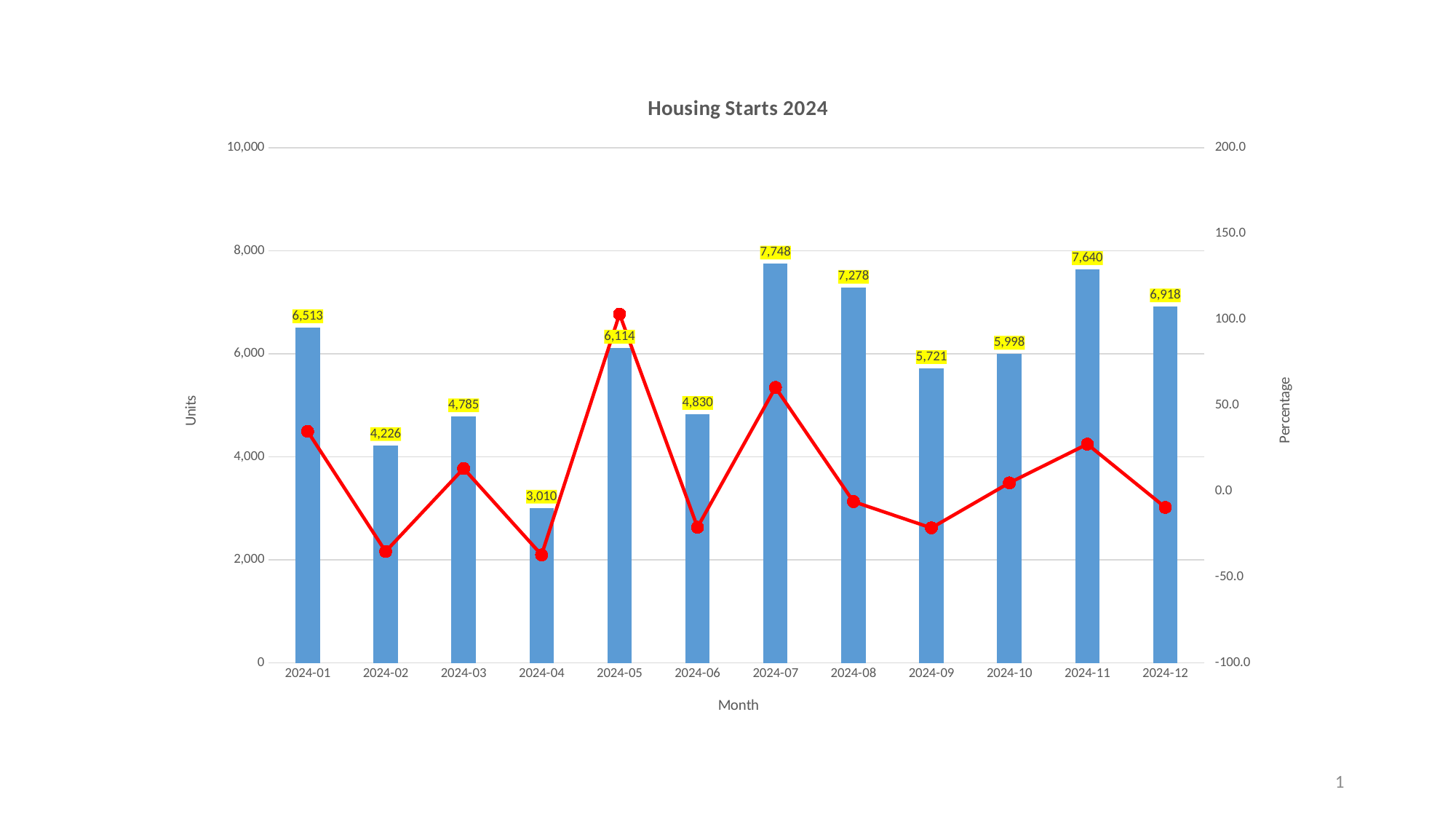
Do the bar values rise or fall from 2024-07 to 2024-09? fall What is the difference between the bar values for 2024-01 and 2024-02? 2,287 What is the value for 2024-07 in the Housing Starts 2024 chart? 7,748 What is the difference between the bar values for 2024-07 and 2024-04? 4,738 Which month has the lowest bar in the Housing Starts 2024 chart? 2024-04 How many months are shown on the x axis of the Housing Starts 2024 chart? 12 Is the percentage value (red line) for 2024-02 greater or less than 0.0? less Is the percentage value (red line) for 2024-07 greater or less than 50.0? greater Which month has a larger bar value, 2024-08 or 2024-11? 2024-11 Which month has the highest bar in the Housing Starts 2024 chart? 2024-07 What is the value for 2024-04 in the Housing Starts 2024 chart? 3,010 What is the value for 2024-10 in the Housing Starts 2024 chart? 5,998